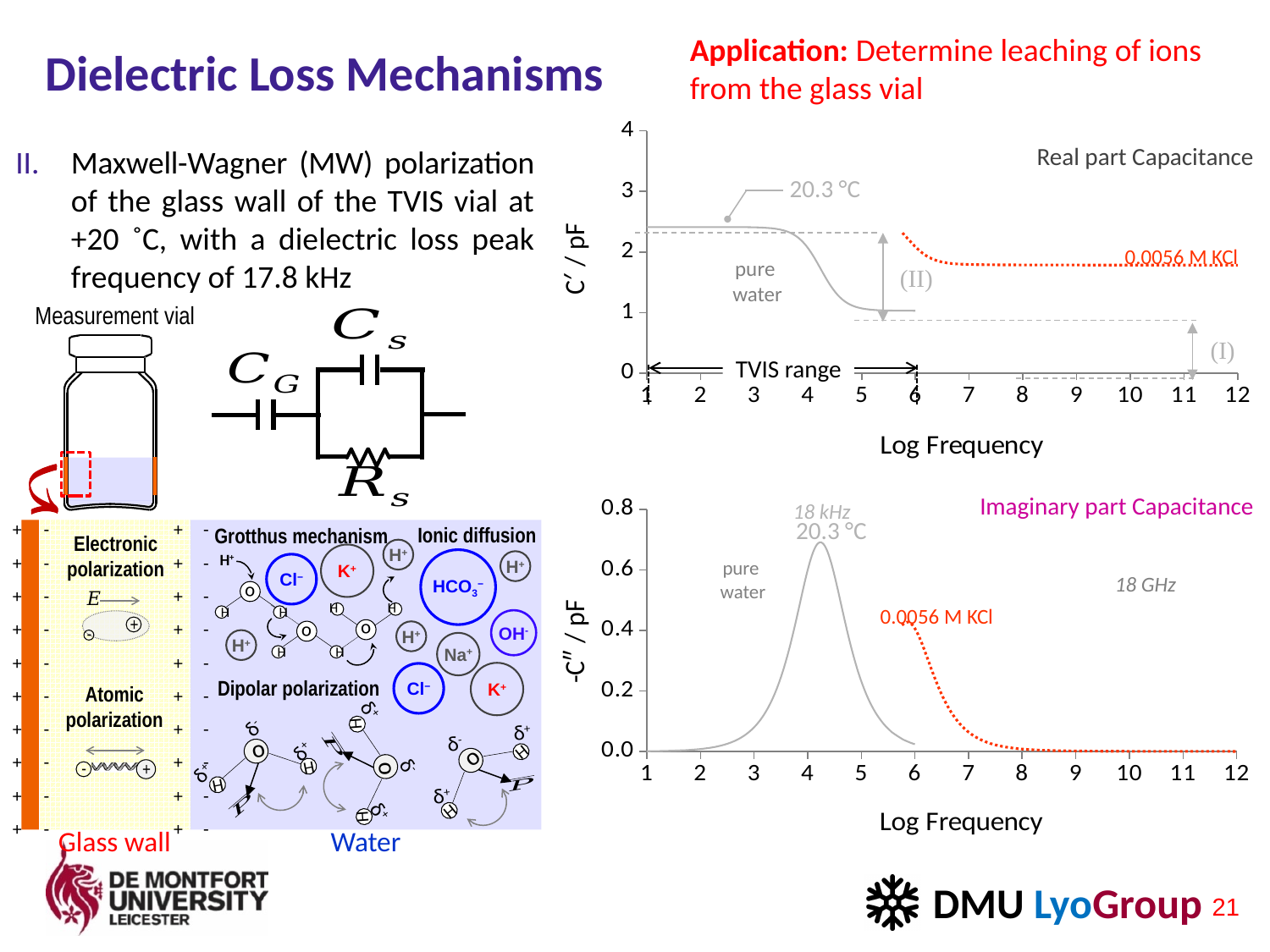
How many data series are plotted in the 'Imaginary part Capacitance' chart? 2 In the 'Real part Capacitance' chart, is the pure water value at log frequency 2 greater or less than 2? greater In the 'Imaginary part Capacitance' chart, what frequency is labelled at the peak of the pure water curve? 18 kHz In the 'Real part Capacitance' chart, does the pure water curve rise or fall between log frequency 3 and log frequency 6? fall In the 'Real part Capacitance' chart, what is the y-axis label? C′ / pF In the 'Imaginary part Capacitance' chart, is the peak value of the pure water curve greater or less than 0.6? greater In the 'Imaginary part Capacitance' chart, is the 0.0056 M KCl value at log frequency 10 greater or less than 0.2? less In the 'Imaginary part Capacitance' chart, does the pure water curve rise or fall between log frequency 2 and log frequency 4? rise What kind of chart is the 'Real part Capacitance' chart? line chart In the 'Imaginary part Capacitance' chart, what is the x-axis label? Log Frequency